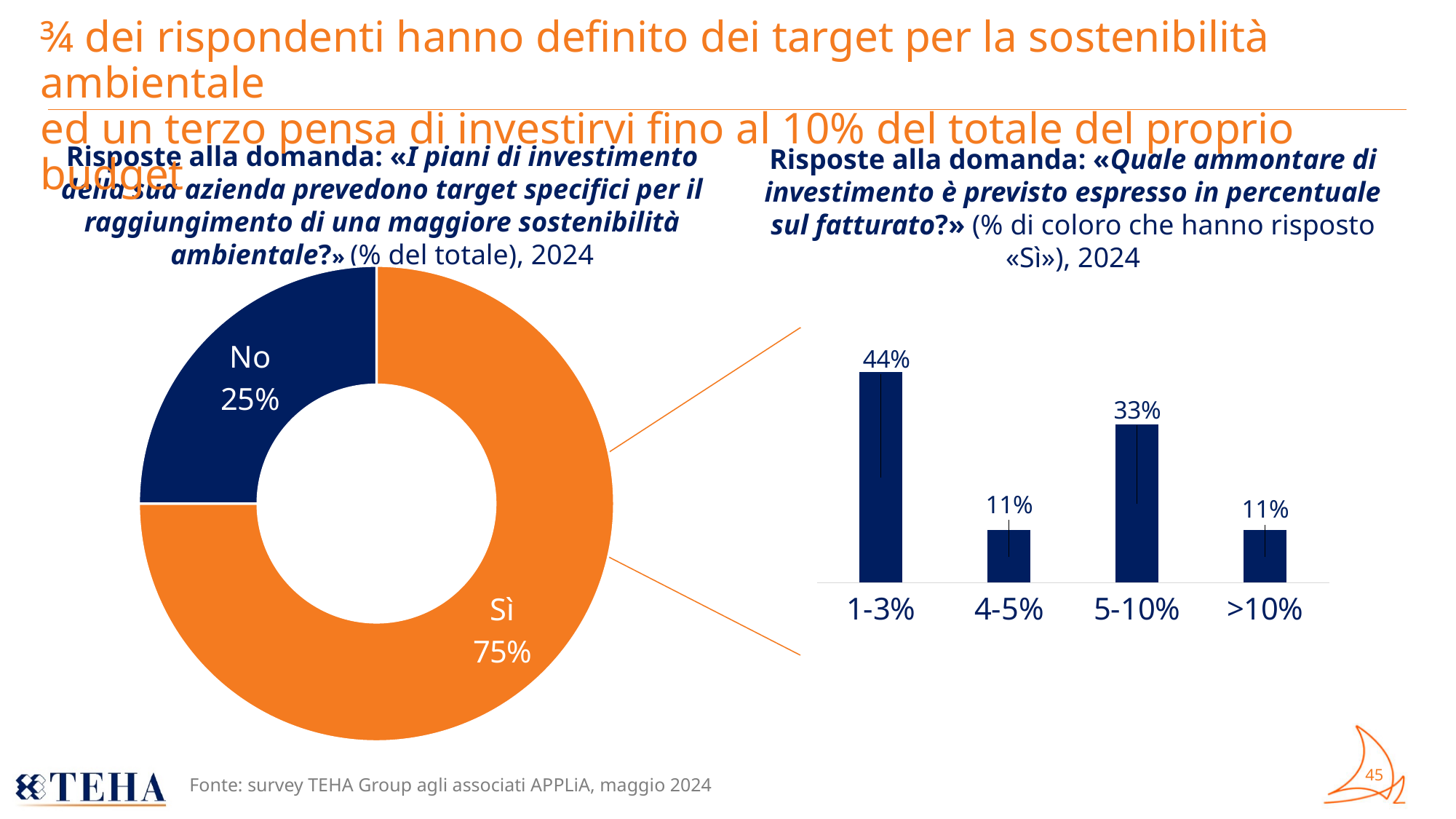
In the bar chart on the right, which is larger: the value for "4-5%" or the value for "5-10%"? 5-10% How many categories are shown in the bar chart on the right? 4 In the bar chart on the right, what is the value for the "5-10%" category? 33% What kind of chart is the chart on the left of the slide? Donut (pie) chart In the donut chart on the left, what is the difference between the "Sì" and "No" shares? 50 percentage points In the bar chart on the right, what is the difference between the values for "1-3%" and "5-10%"? 11 percentage points In the donut chart on the left, what share of respondents answered "No"? 25% In the bar chart on the right, what is the value for the "1-3%" category? 44% In the bar chart on the right, what is the value for the ">10%" category? 11% In the donut chart on the left, what share of respondents answered "Sì"? 75% What kind of chart is the chart on the right of the slide? Bar chart In the bar chart on the right, which category has the highest value? 1-3%